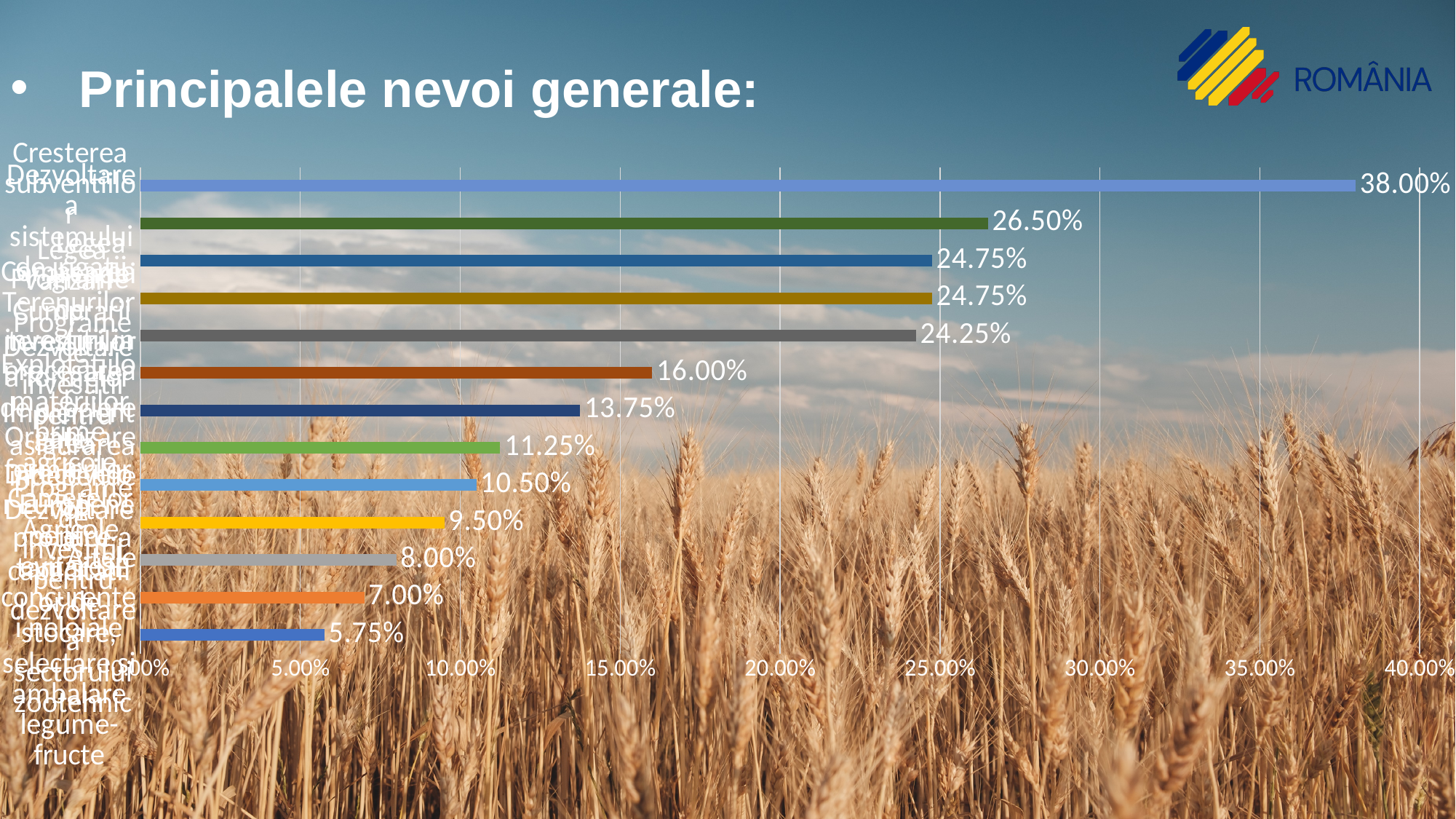
Is the value of the fifth bar from the top greater or less than 20.00%? greater What is the lowest value shown in the chart? 5.75% What is the maximum value shown on the horizontal axis? 40.00% What is the title text shown above the chart? Principalele nevoi generale: What is the highest value shown in the chart? 38.00% What is the value of the topmost (longest) bar in the chart? 38.00% What is the value of the bottom bar in the chart? 5.75% Which is larger: the value of the sixth bar from the top (16.00%) or the seventh bar from the top (13.75%)? 16.00% What kind of chart is shown on the slide? bar chart How many bars are plotted in the chart? 13 What is the value of the second bar from the top? 26.50% What is the difference between the top bar (38.00%) and the second bar (26.50%)? 11.50%